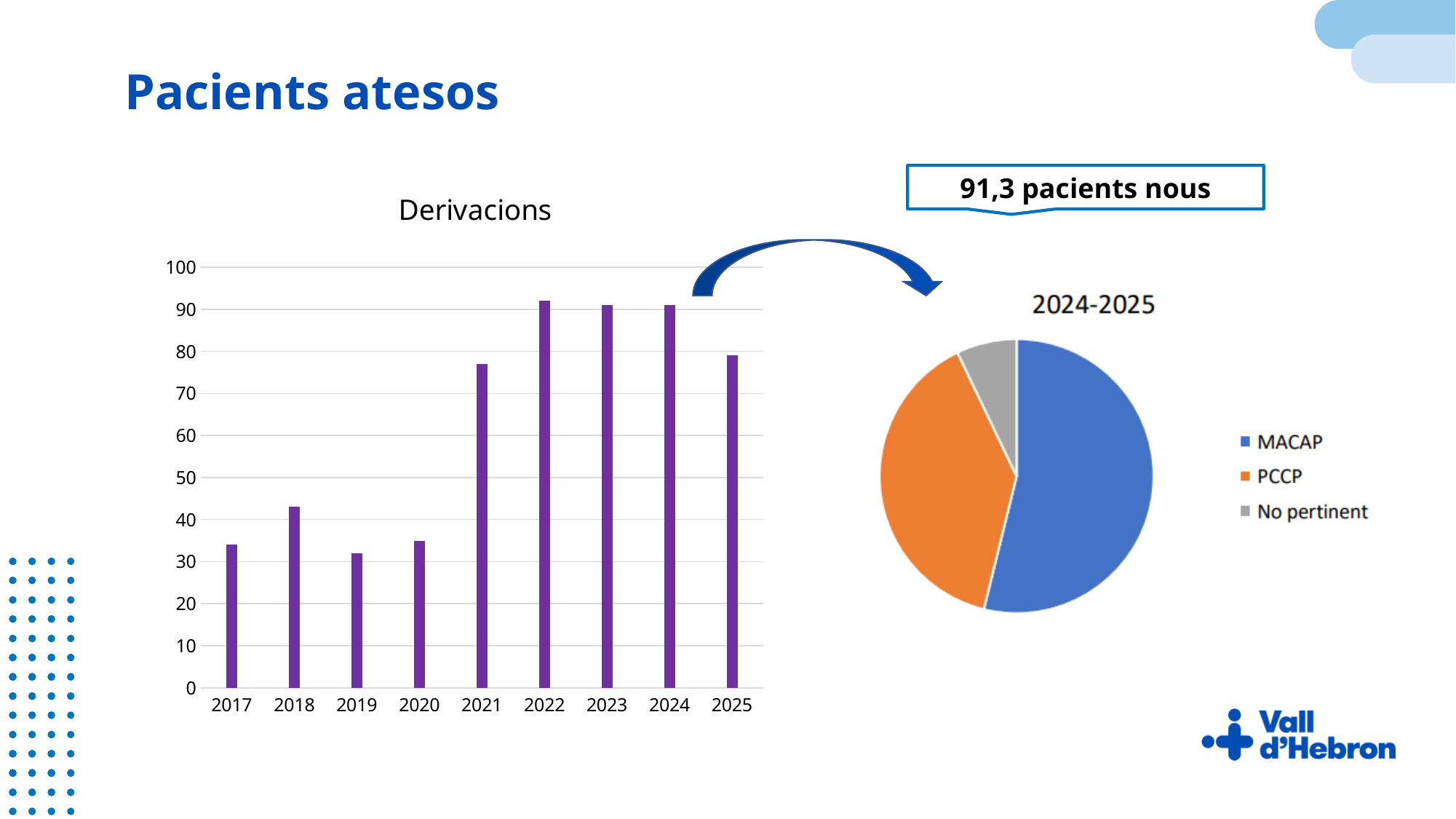
In the "Derivacions" chart, is the value for 2021 greater or less than 70? greater In the "Derivacions" chart, which year has the larger value, 2018 or 2021? 2021 What kind of chart is the "Derivacions" chart? bar chart In the "Derivacions" chart, is the value for 2019 greater or less than 40? less In the "2024-2025" pie chart, which category has the smallest slice? No pertinent How many categories does the legend of the "2024-2025" pie chart list? 3 In the "Derivacions" chart, is the value for 2022 greater or less than 80? greater What kind of chart is the "2024-2025" chart? pie chart In the "Derivacions" chart, which year has the larger value, 2020 or 2025? 2025 In the "2024-2025" pie chart, which category has the largest slice? MACAP How many years are shown on the x axis of the "Derivacions" chart? 9